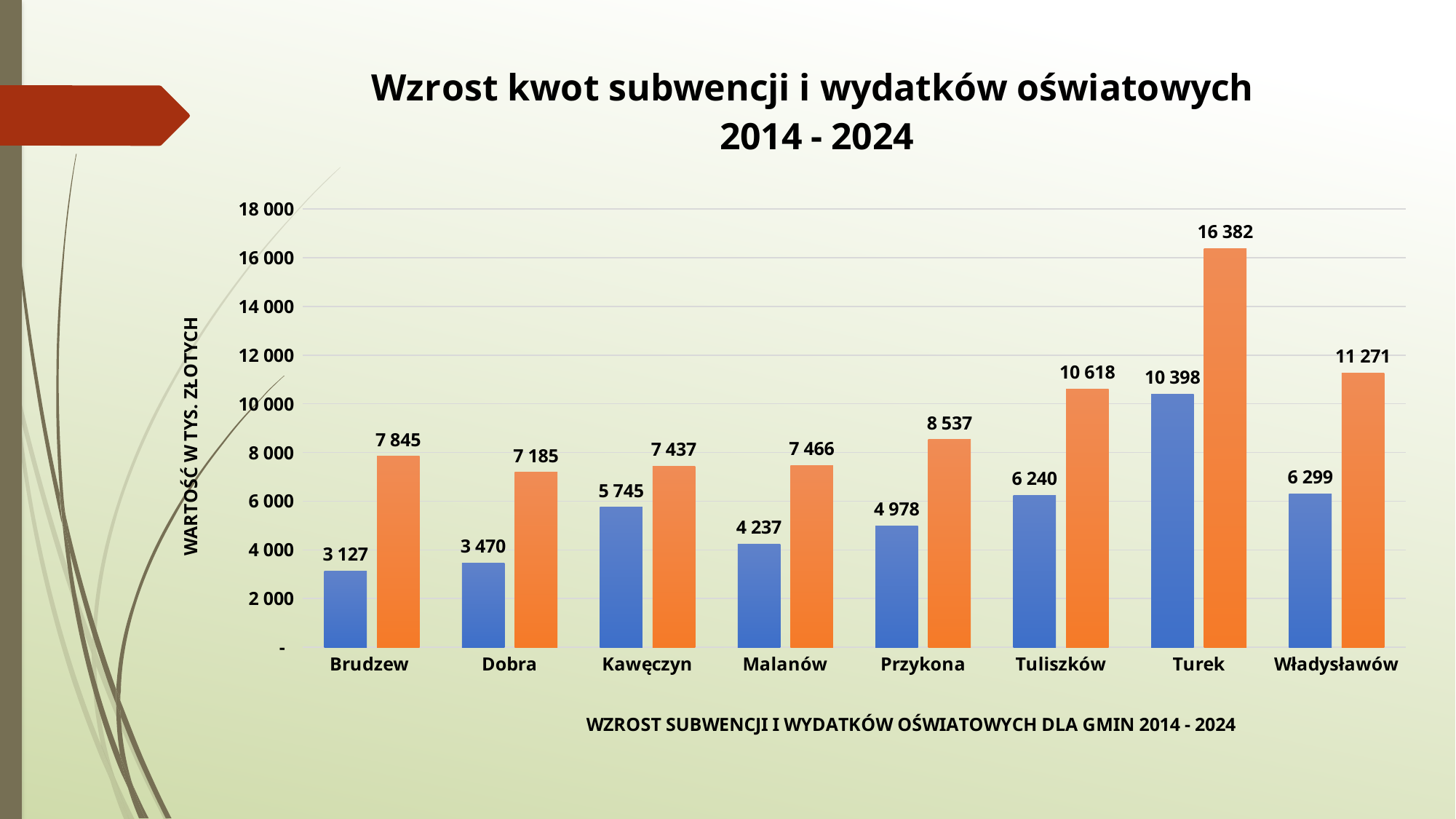
What is the value of the blue bar for Tuliszków? 6 240 Which is larger: the orange bar for Przykona or the orange bar for Malanów? Przykona Which category has the highest orange bar? Turek What is the difference between the orange and blue bars for Brudzew? 4 718 What is the label of the vertical axis? WARTOŚĆ W TYS. ZŁOTYCH What kind of chart is shown on the slide? Bar chart What is the difference between the orange and blue bars for Turek? 5 984 What is the value of the orange bar for Władysławów? 11 271 What is the value of the orange bar for Turek? 16 382 Which category has the lowest blue bar? Brudzew What is the value of the blue bar for Brudzew? 3 127 How many categories are shown on the x axis? 8